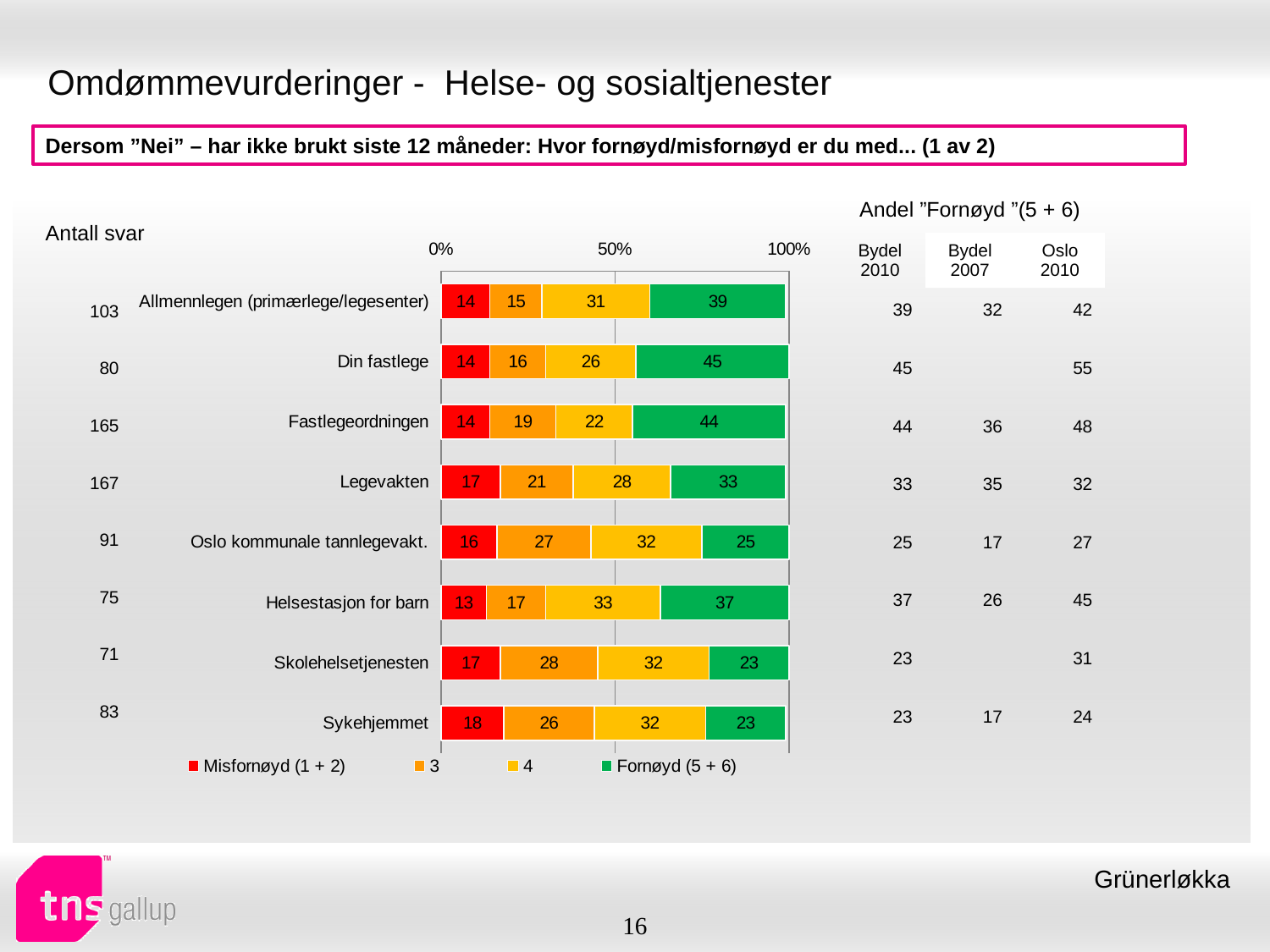
What is the value of series 3 for Oslo kommunale tannlegevakt.? 27 How many categories (services) are plotted in the chart? 8 Which has a larger Fornøyd (5 + 6) value, Legevakten or Skolehelsetjenesten? Legevakten What kind of chart is shown on the slide? Stacked bar chart What is the value of series 4 for Helsestasjon for barn? 33 What is the total of the stacked bar for Legevakten? 99 What is the Fornøyd (5 + 6) value for Din fastlege? 45 What is the difference between the Fornøyd (5 + 6) values for Din fastlege and Sykehjemmet? 22 Which category has the highest Fornøyd (5 + 6) value? Din fastlege Which category has the lowest Misfornøyd (1 + 2) value? Helsestasjon for barn How many series does the chart legend list? 4 What is the Misfornøyd (1 + 2) value for Sykehjemmet? 18